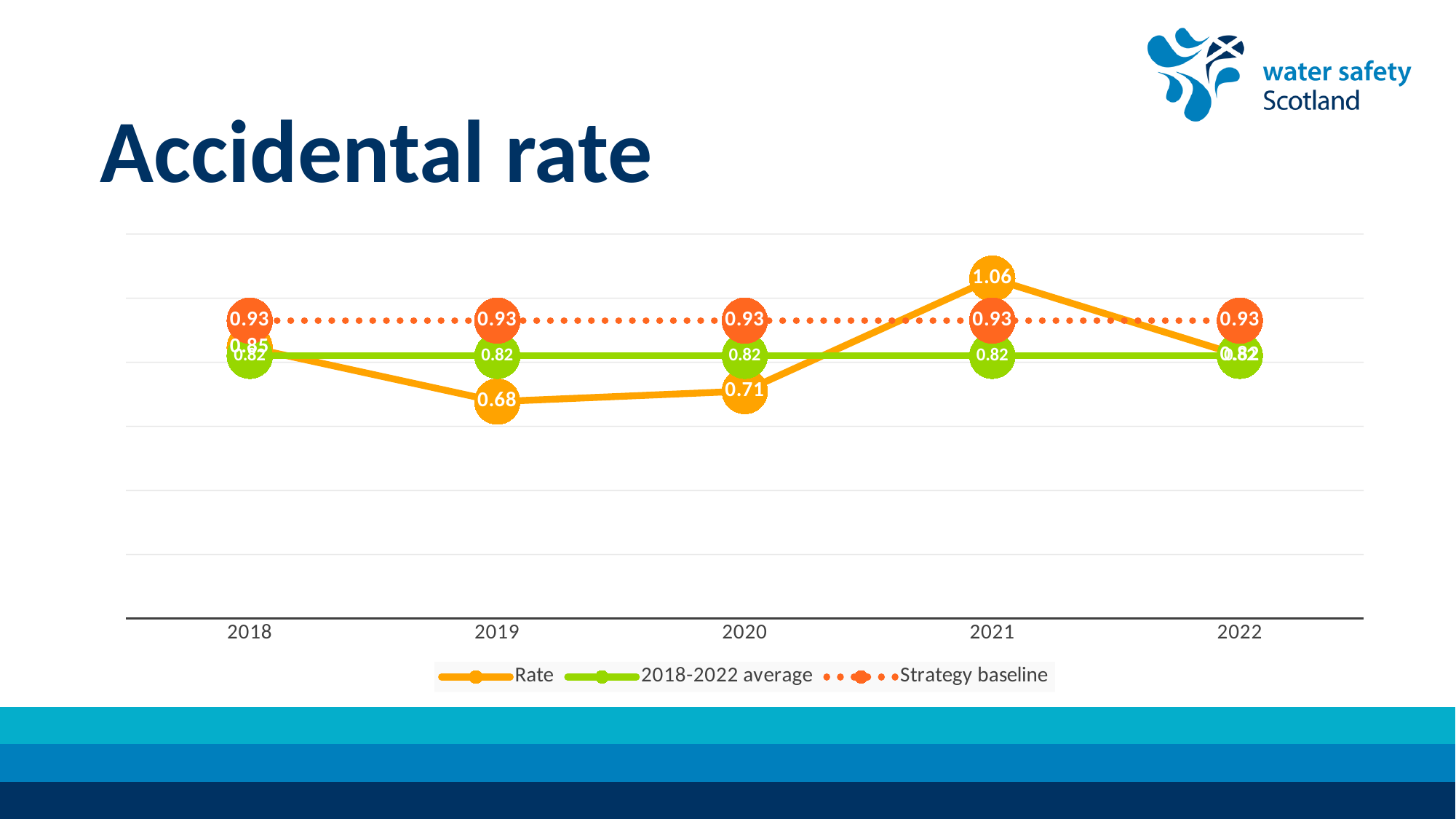
What type of chart is shown on the slide? line chart What is the Rate value for 2020? 0.71 What is the difference between the Rate in 2021 and the Rate in 2019? 0.38 Which is larger, the Rate in 2021 or the Strategy baseline in 2021? Rate in 2021 What is the Rate value for 2021? 1.06 In which year is the Rate lowest? 2019 How many series does the legend list? 3 In which year is the Rate highest? 2021 What is the Rate value for 2018? 0.85 What is the Strategy baseline value shown for 2020? 0.93 What is the 2018-2022 average value shown for 2021? 0.82 What is the Rate value for 2019? 0.68